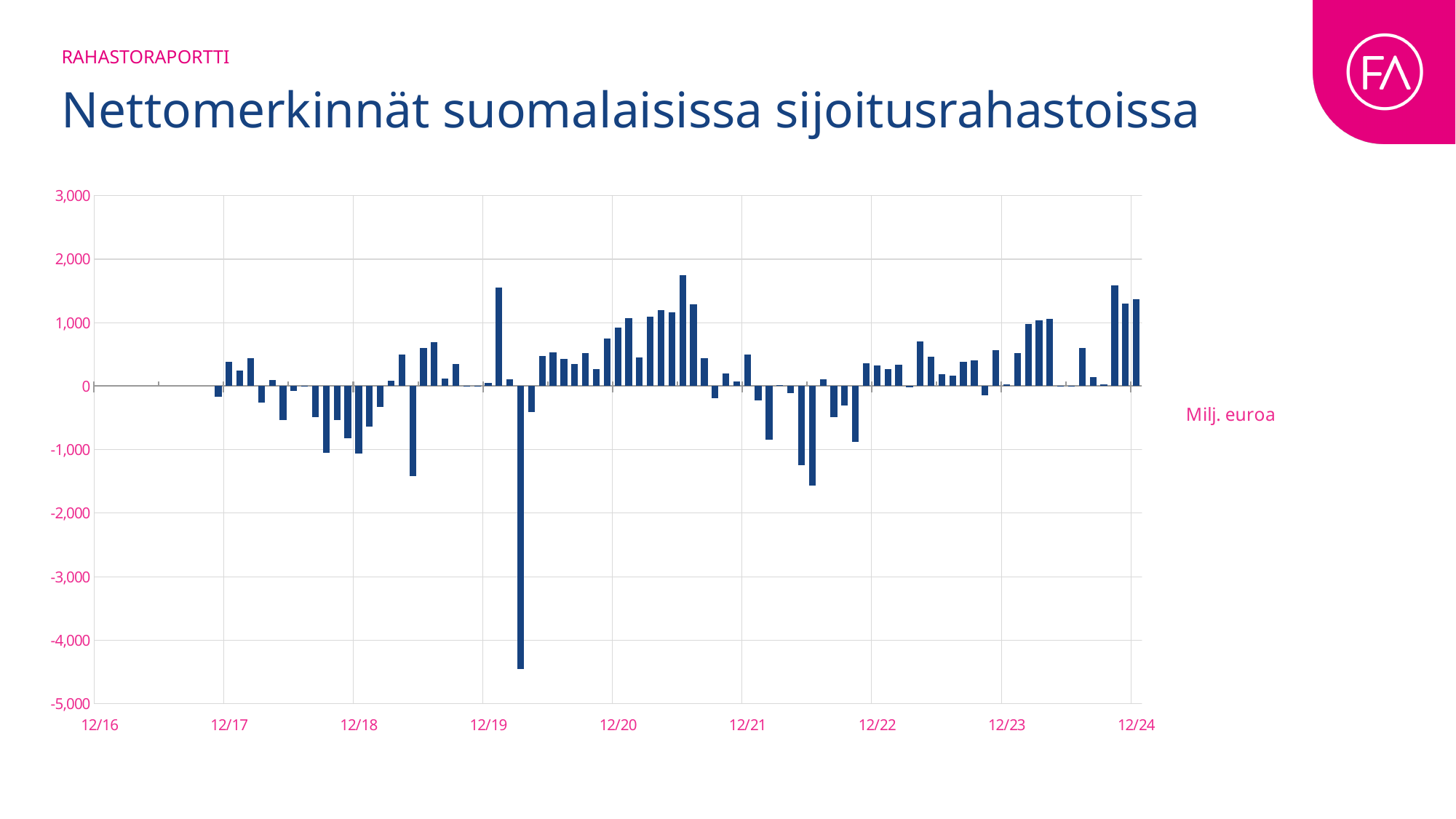
What kind of chart is shown on the slide? bar chart What is the last label on the horizontal axis? 12/24 Between which x-axis labels does the lowest bar in the chart fall? 12/19 and 12/20 What unit is shown next to the chart? Milj. euroa What is the first label on the horizontal axis? 12/16 Is the highest bar in the chart greater or less than 2,000? less Is the lowest bar in the chart greater or less than -4,000? less Is the highest bar in the chart greater or less than 1,000? greater